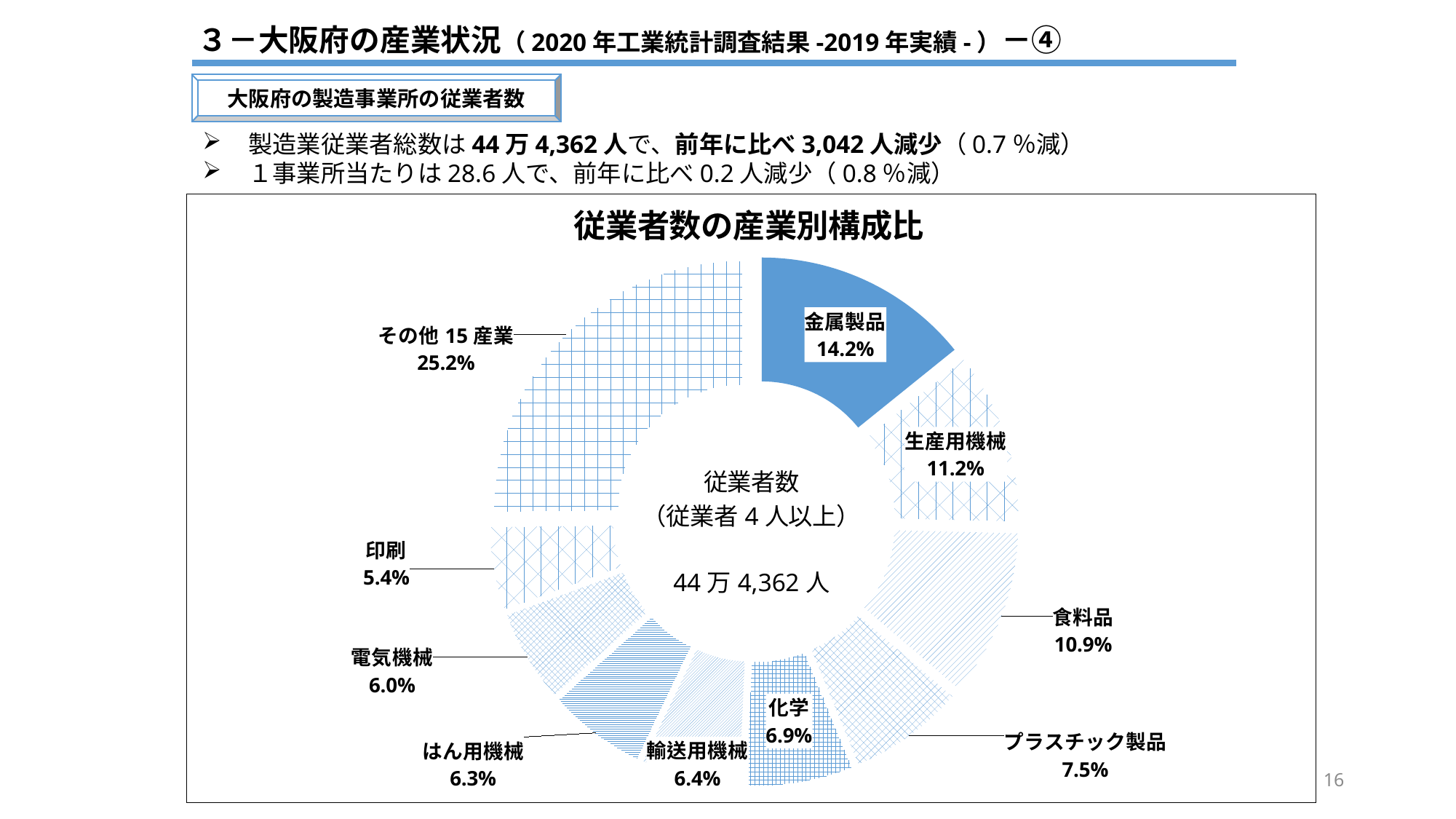
What share of employees does 金属製品 account for? 14.2% What is the title of the chart? 従業者数の産業別構成比 What is the share for その他15産業? 25.2% What kind of chart is shown on the slide? Doughnut (pie) chart Which has a larger share, 化学 or プラスチック製品? プラスチック製品 What total number of employees is shown in the centre of the chart? 44万4,362人 What percentage is shown for 食料品? 10.9% What percentage is shown for 印刷? 5.4% Among the individually named industries (excluding その他15産業), which has the largest share? 金属製品 How many slices does the doughnut chart have? 10 Which slice has the smallest share? 印刷 What is the difference in percentage points between 金属製品 and 生産用機械? 3.0 percentage points